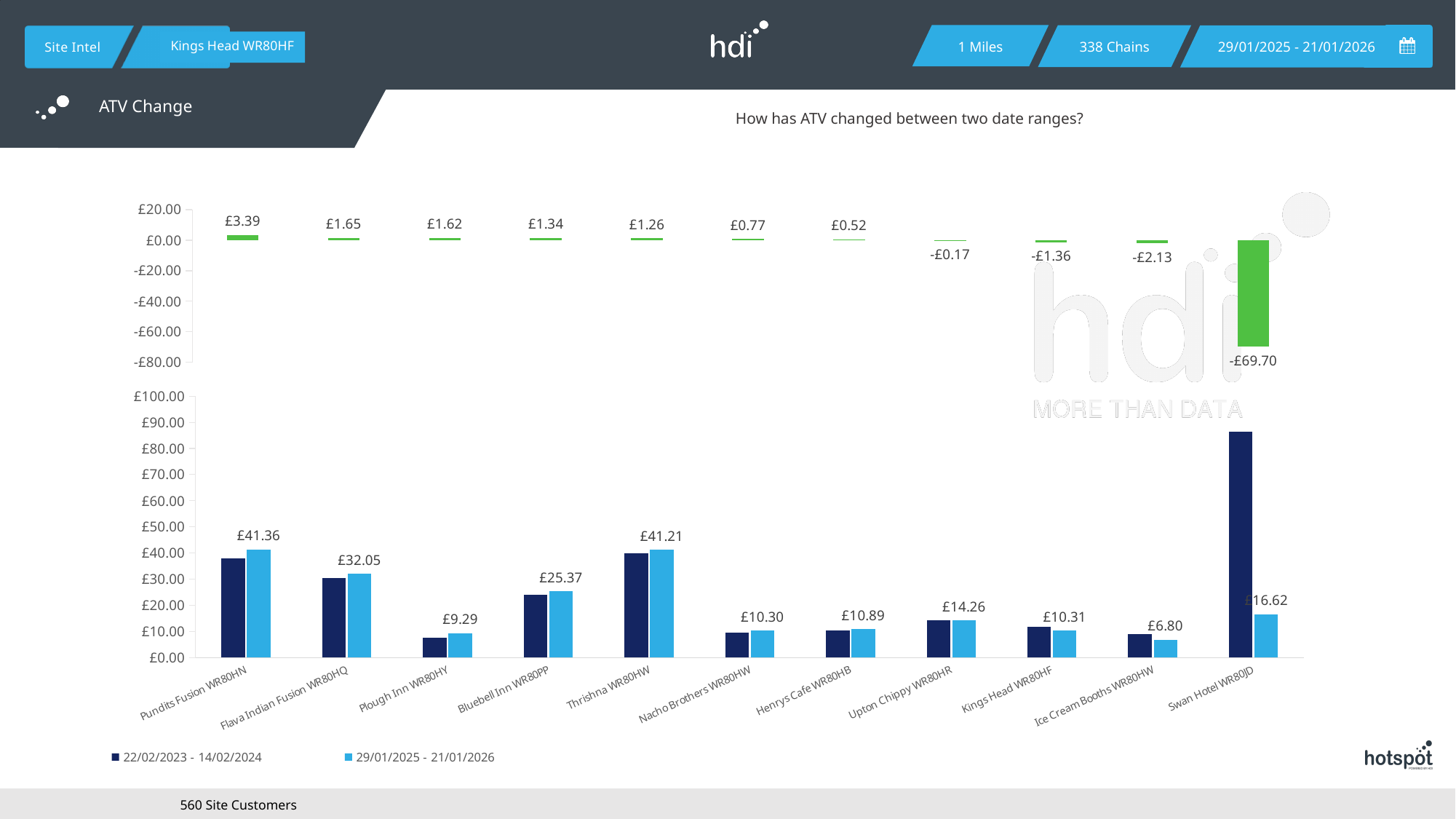
In the top chart, what is the ATV change for Pundits Fusion WR80HN? £3.39 How many series does the legend of the bottom chart list? 2 What type of chart is the bottom chart? Bar chart In the top chart, what is the difference between the ATV change for Pundits Fusion WR80HN and Flava Indian Fusion WR80HQ? £1.74 In the bottom chart, what is the value for Ice Cream Booths WR80HW in the 29/01/2025 - 21/01/2026 series? £6.80 In the top chart, what is the ATV change for Swan Hotel WR80JD? -£69.70 In the top chart, which site has the lowest ATV change? Swan Hotel WR80JD In the bottom chart, is the value for Swan Hotel WR80JD in the 22/02/2023 - 14/02/2024 series greater or less than £80.00? greater In the top chart, which site has the highest ATV change? Pundits Fusion WR80HN In the bottom chart, which is larger in the 29/01/2025 - 21/01/2026 series: Bluebell Inn WR80PP or Upton Chippy WR80HR? Bluebell Inn WR80PP In the bottom chart, what is the value for Thrishna WR80HW in the 29/01/2025 - 21/01/2026 series? £41.21 How many sites are shown on the x axis of the bottom chart? 11